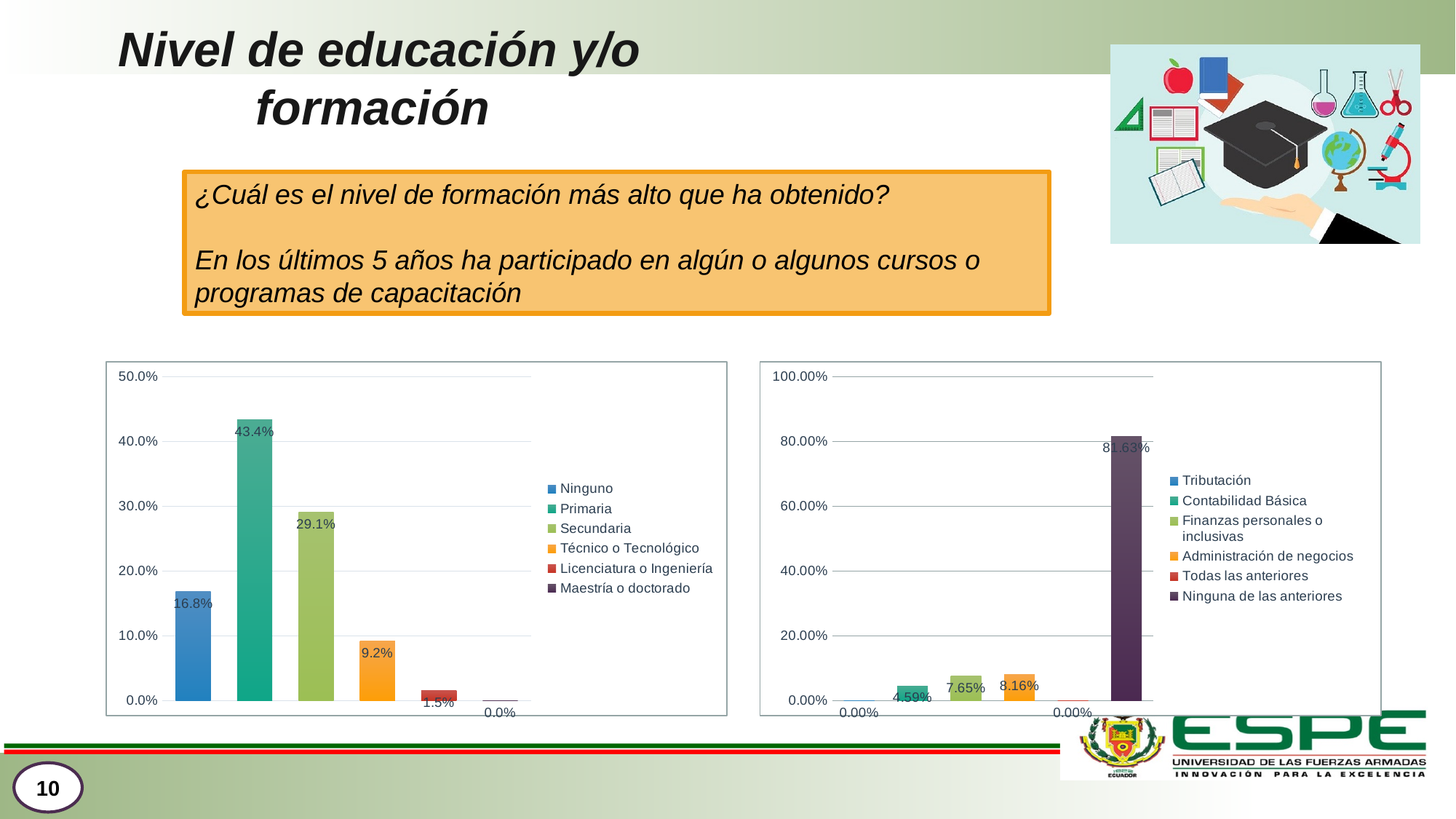
How many legend entries does the left chart list? 6 In the left chart, what is the value for Primaria? 43.4% In the left chart, what is the difference between the values for Primaria and Secundaria? 14.3% In the left chart, which is larger: Ninguno or Secundaria? Secundaria In the right chart, what is the difference between the values for Administración de negocios and Finanzas personales o inclusivas? 0.51% In the left chart, which category has the highest value? Primaria In the left chart, which category has the lowest value? Maestría o doctorado In the right chart, what is the value for Ninguna de las anteriores? 81.63% In the right chart, what is the value for Contabilidad Básica? 4.59% In the left chart, what is the value for Técnico o Tecnológico? 9.2% What kind of chart is the right chart? Bar chart In the right chart, which category has the highest value? Ninguna de las anteriores